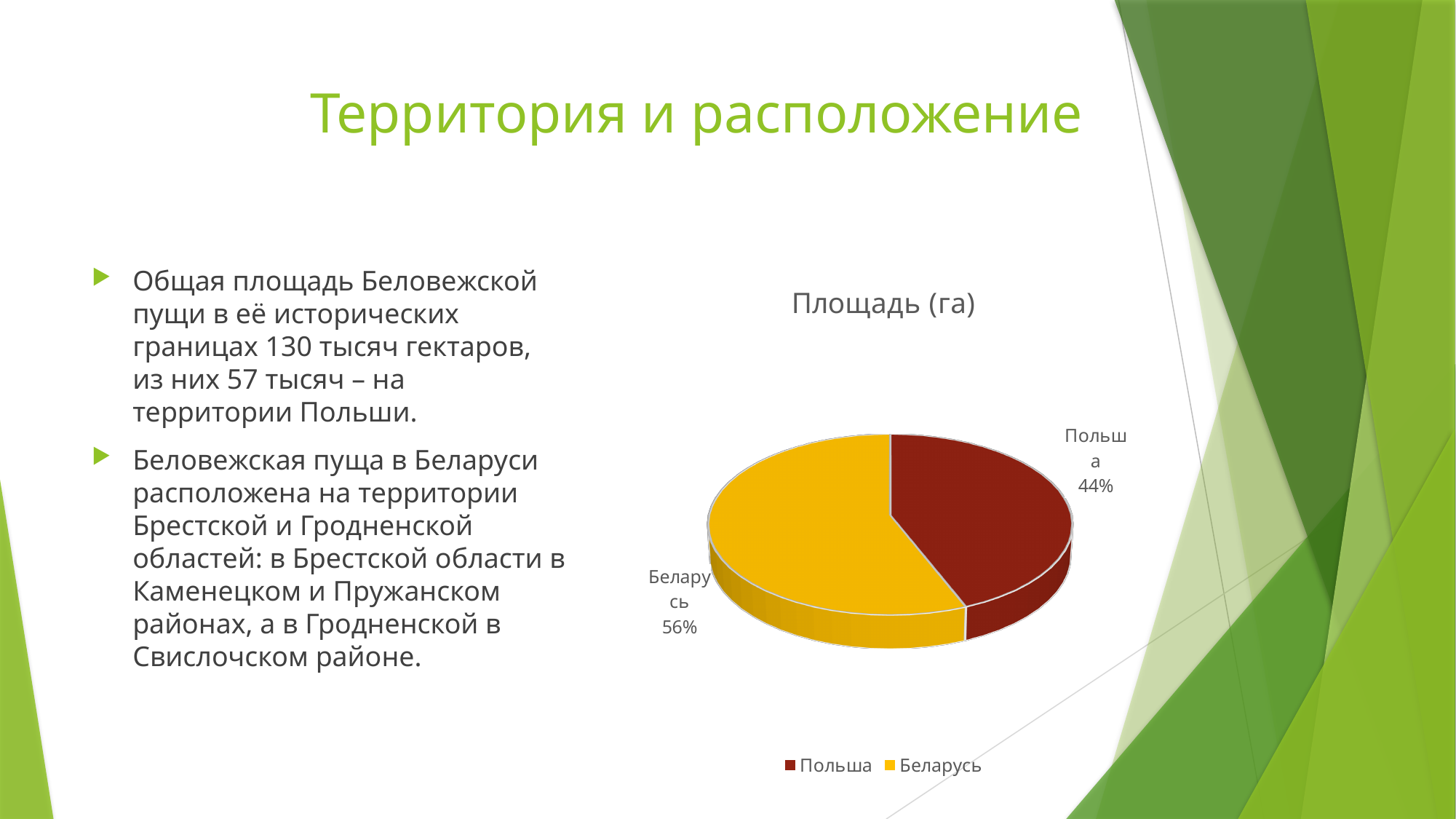
What share of the pie does Польша have? 44% How many slices does the pie chart have? 2 Which is larger, the share for Польша or the share for Беларусь? Беларусь What colour is the Беларусь slice? yellow Which slice of the pie is the smallest? Польша What kind of chart is shown on the slide? pie chart How many entries does the legend list? 2 What is the difference in percentage points between the Беларусь share and the Польша share? 12 Which slice of the pie is the largest? Беларусь What is the title of the chart? Площадь (га) What share of the pie does Беларусь have? 56%